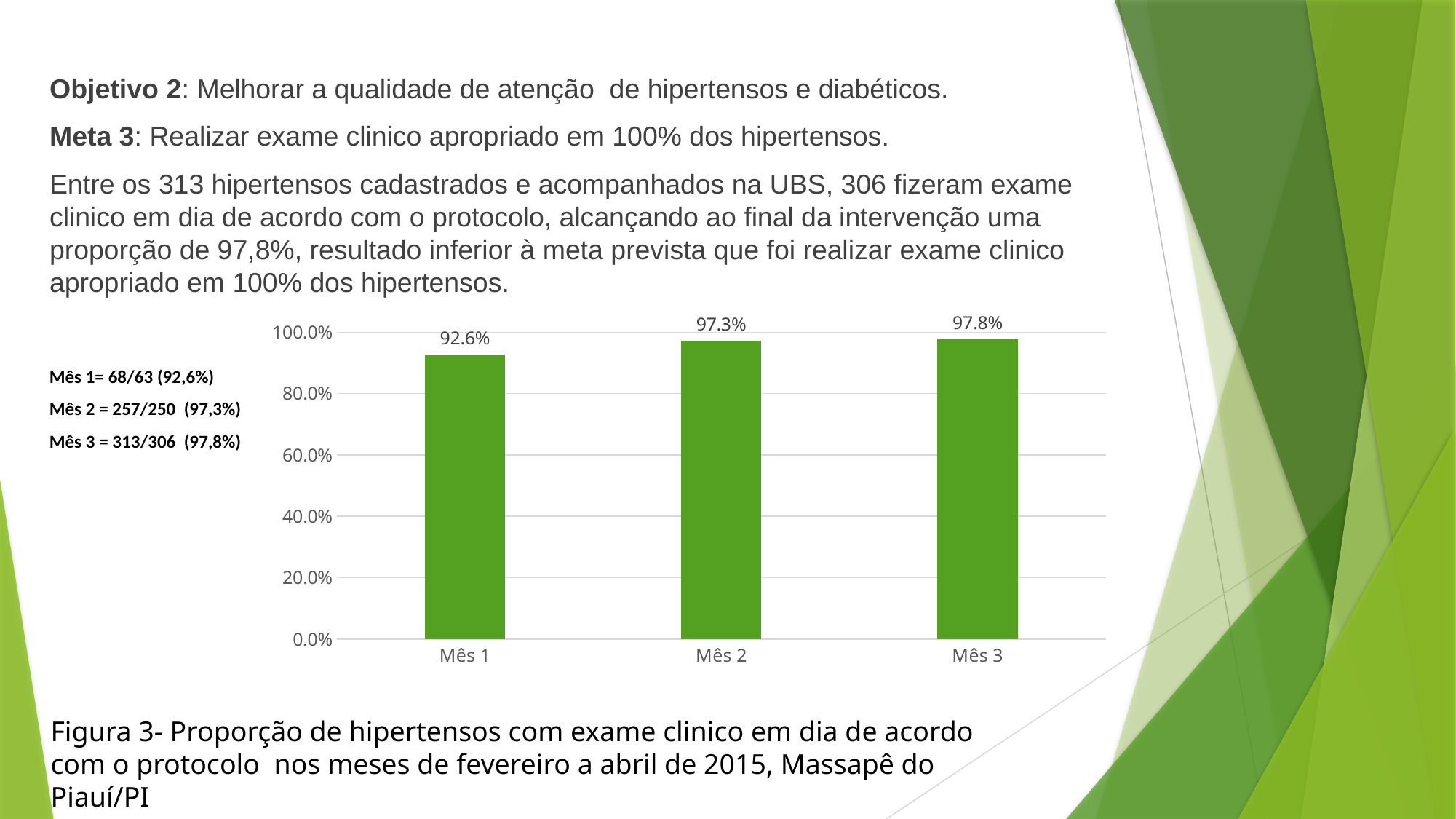
What is the difference between the values for Mês 2 and Mês 1? 4.7% What kind of chart is shown on the slide? bar chart Is the value for Mês 1 greater or less than 80.0%? greater What is the value for Mês 2? 97.3% Which is larger, the value for Mês 1 or the value for Mês 2? Mês 2 What is the value for Mês 3? 97.8% Which month has the highest value? Mês 3 How many bars are shown in the chart? 3 What is the value for Mês 1? 92.6% Do the values rise or fall from Mês 1 to Mês 3? rise What is the difference between the values for Mês 3 and Mês 1? 5.2% Which month has the lowest value? Mês 1